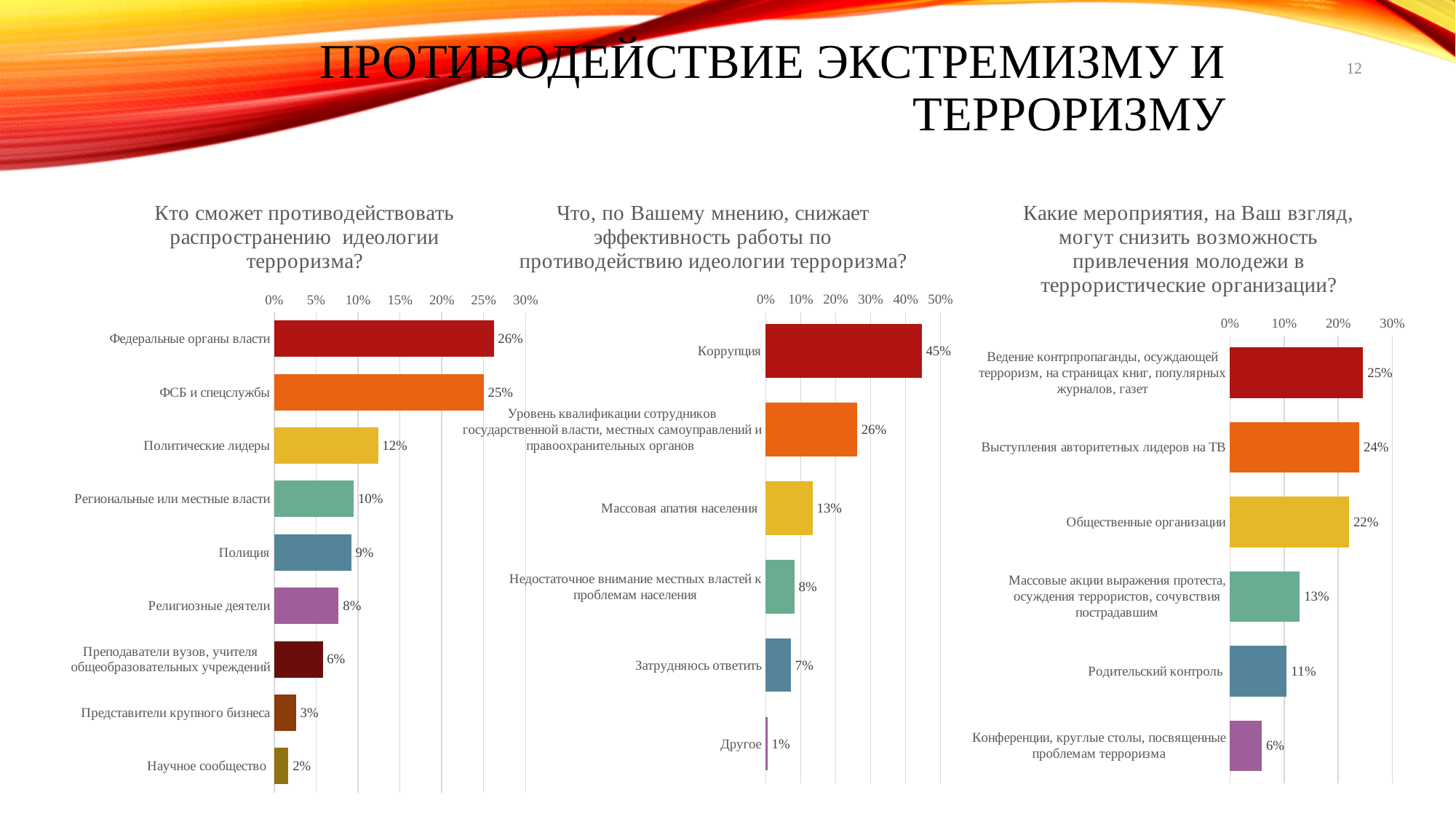
In the middle chart ("Что, по Вашему мнению, снижает эффективность работы по противодействию идеологии терроризма?"), how many categories are shown? 6 What type of chart is the right chart ("Какие мероприятия, на Ваш взгляд, могут снизить возможность привлечения молодежи в террористические организации?")? Bar chart In the left chart ("Кто сможет противодействовать распространению идеологии терроризма?"), how many categories are shown? 9 In the left chart ("Кто сможет противодействовать распространению идеологии терроризма?"), which category has the lowest value? Научное сообщество In the middle chart ("Что, по Вашему мнению, снижает эффективность работы по противодействию идеологии терроризма?"), what is the value for "Массовая апатия населения"? 13% In the right chart ("Какие мероприятия, на Ваш взгляд, могут снизить возможность привлечения молодежи в террористические организации?"), which category has the lowest value? Конференции, круглые столы, посвященные проблемам терроризма In the middle chart ("Что, по Вашему мнению, снижает эффективность работы по противодействию идеологии терроризма?"), which is larger: "Затрудняюсь ответить" or "Другое"? Затрудняюсь ответить In the right chart ("Какие мероприятия, на Ваш взгляд, могут снизить возможность привлечения молодежи в террористические организации?"), what is the difference between "Общественные организации" and "Массовые акции выражения протеста, осуждения террористов, сочувствия пострадавшим"? 9% In the left chart ("Кто сможет противодействовать распространению идеологии терроризма?"), what is the difference between "Федеральные органы власти" and "Политические лидеры"? 14% In the middle chart ("Что, по Вашему мнению, снижает эффективность работы по противодействию идеологии терроризма?"), which category has the highest value? Коррупция In the left chart ("Кто сможет противодействовать распространению идеологии терроризма?"), what is the value for "Полиция"? 9% In the right chart ("Какие мероприятия, на Ваш взгляд, могут снизить возможность привлечения молодежи в террористические организации?"), what is the value for "Родительский контроль"? 11%